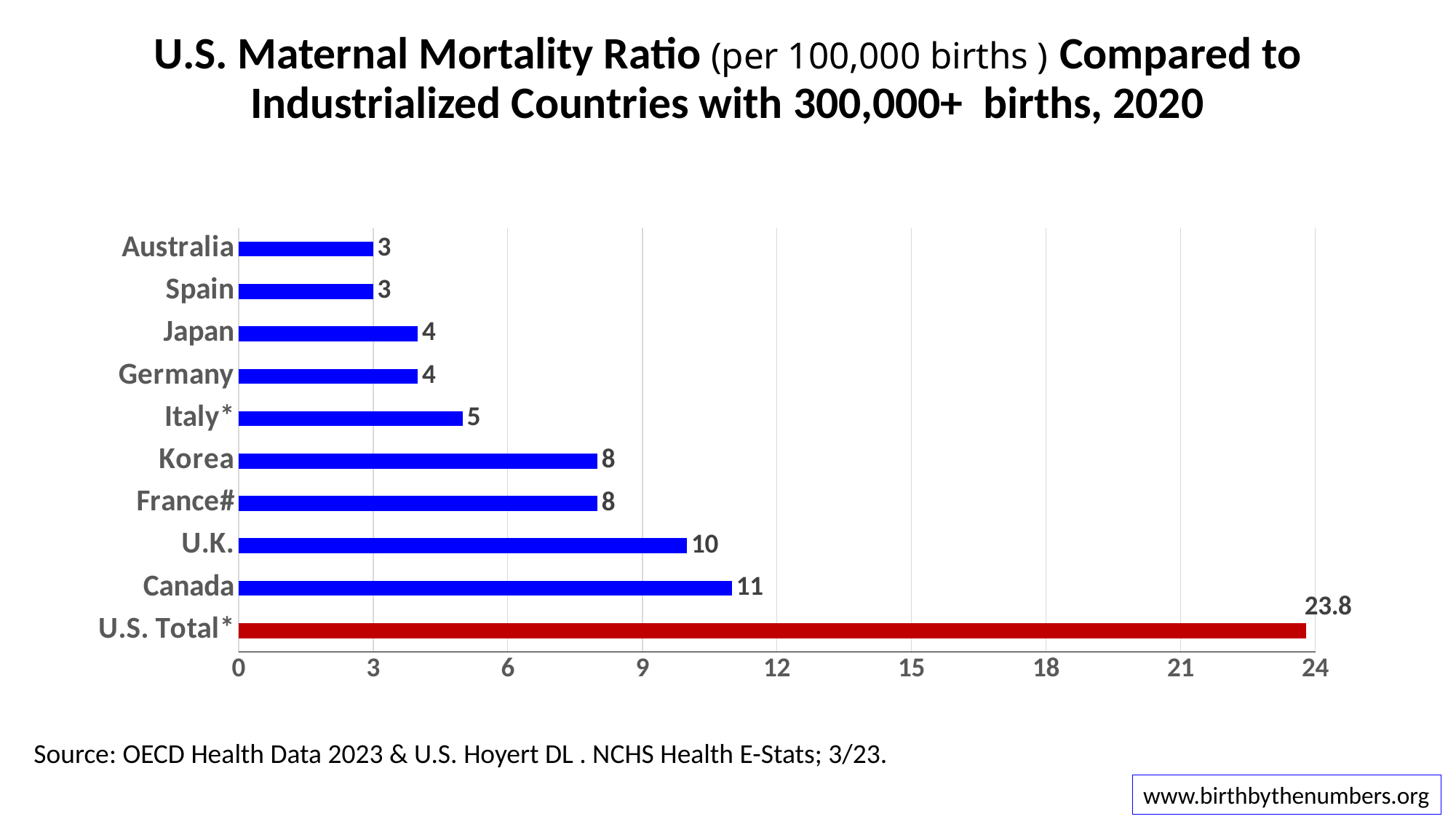
What is the maternal mortality ratio shown for U.S. Total*? 23.8 What value is shown for both Australia and Spain? 3 What is the difference between the values for U.S. Total* and Canada? 12.8 Which bar is coloured red rather than blue? U.S. Total* Which has a larger value, Korea or Germany? Korea What is the maternal mortality ratio shown for Canada? 11 What kind of chart is shown on the slide? Bar chart What is the difference between the values for U.K. and Japan? 6 How many countries/categories are shown in the chart? 10 Which category has the highest maternal mortality ratio? U.S. Total* Is the value for U.S. Total* greater or less than 21? greater What is the value shown for Italy*? 5